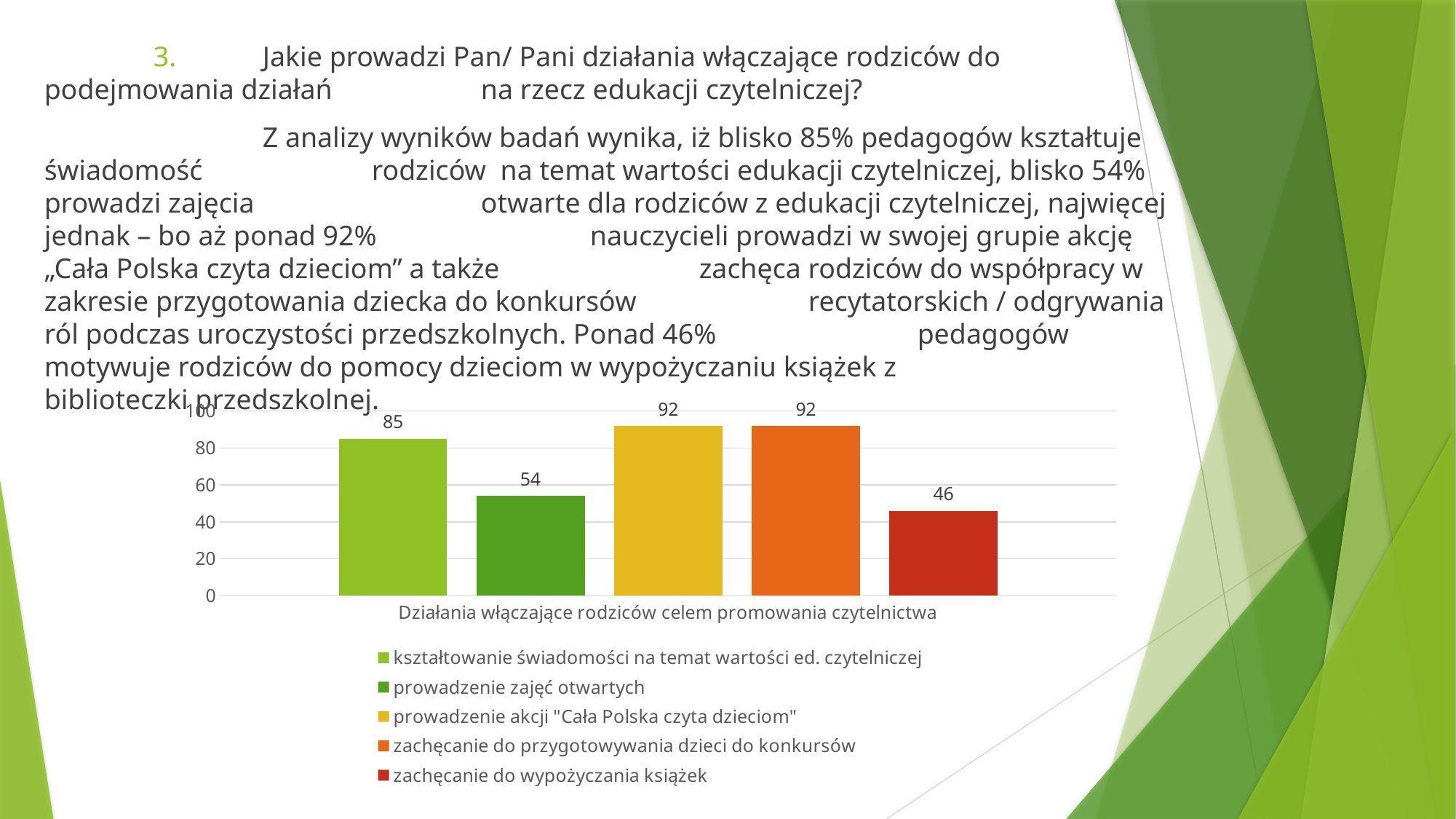
What is the value for "zachęcanie do wypożyczania książek"? 46 Which series has the lowest value? zachęcanie do wypożyczania książek How many series does the legend list? 5 Which is larger: the value for "prowadzenie zajęć otwartych" or the value for "zachęcanie do wypożyczania książek"? prowadzenie zajęć otwartych What is the difference between the values for "kształtowanie świadomości na temat wartości ed. czytelniczej" and "zachęcanie do wypożyczania książek"? 39 What type of chart is shown on the slide? bar chart What is the difference between the values for "prowadzenie akcji "Cała Polska czyta dzieciom"" and "prowadzenie zajęć otwartych"? 38 What colour is the bar for "zachęcanie do przygotowywania dzieci do konkursów"? orange What is the category label shown on the x axis? Działania włączające rodziców celem promowania czytelnictwa What is the value for "kształtowanie świadomości na temat wartości ed. czytelniczej"? 85 What is the value for "prowadzenie akcji "Cała Polska czyta dzieciom""? 92 What is the value for "prowadzenie zajęć otwartych"? 54